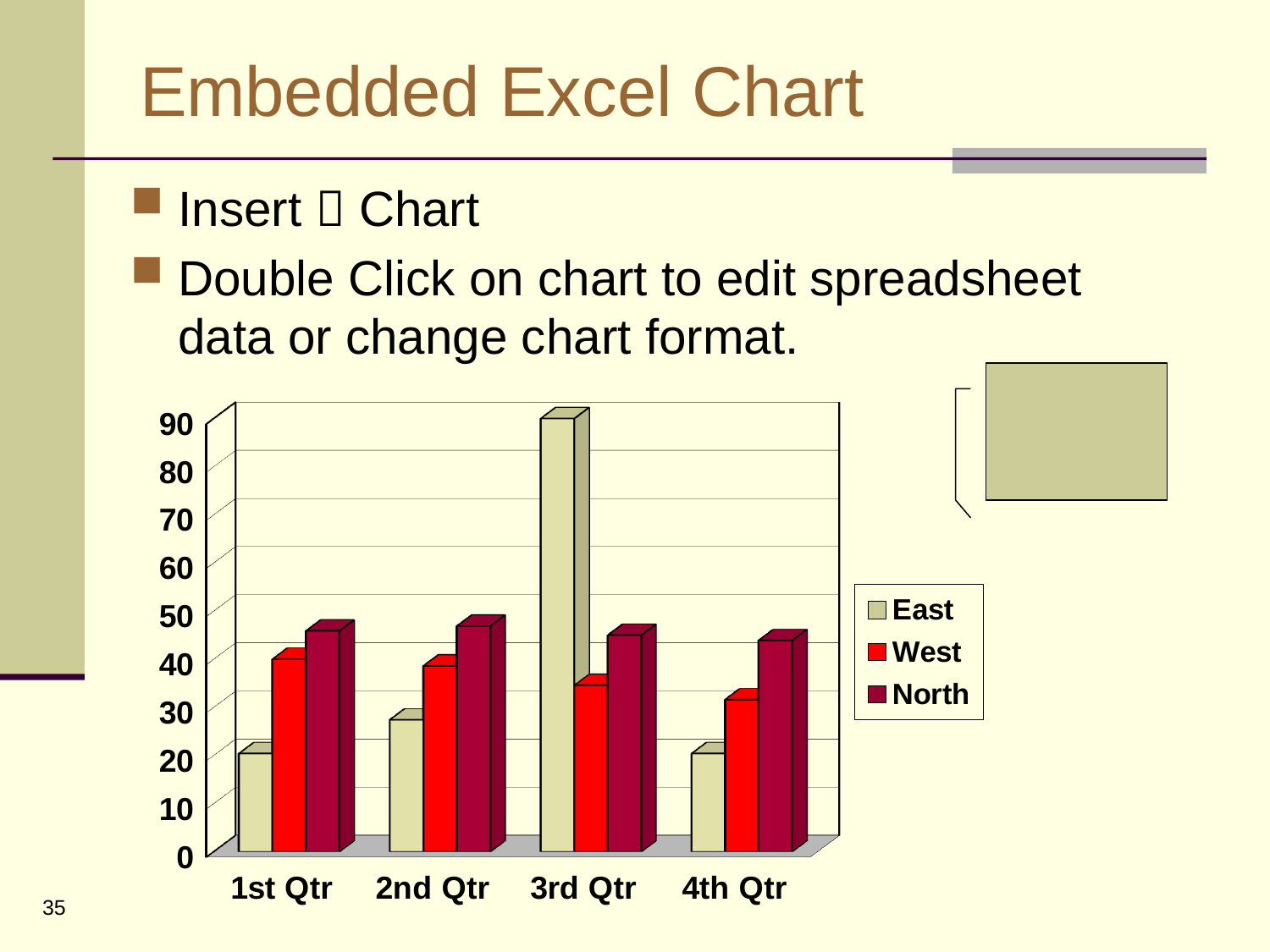
Is the East value for 1st Qtr greater or less than 30? less Is the East value for 3rd Qtr greater or less than 80? greater Is the North value for 1st Qtr greater or less than 50? less How many series does the chart legend list? 3 In 2nd Qtr, which is larger: East or North? North Which series has the tallest bar in the chart? East In which quarter is the West value lowest? 4th Qtr In which quarter is the East value highest? 3rd Qtr What kind of chart is shown on the slide? bar chart In 3rd Qtr, which is larger: East or West? East How many quarters are shown on the x axis of the chart? 4